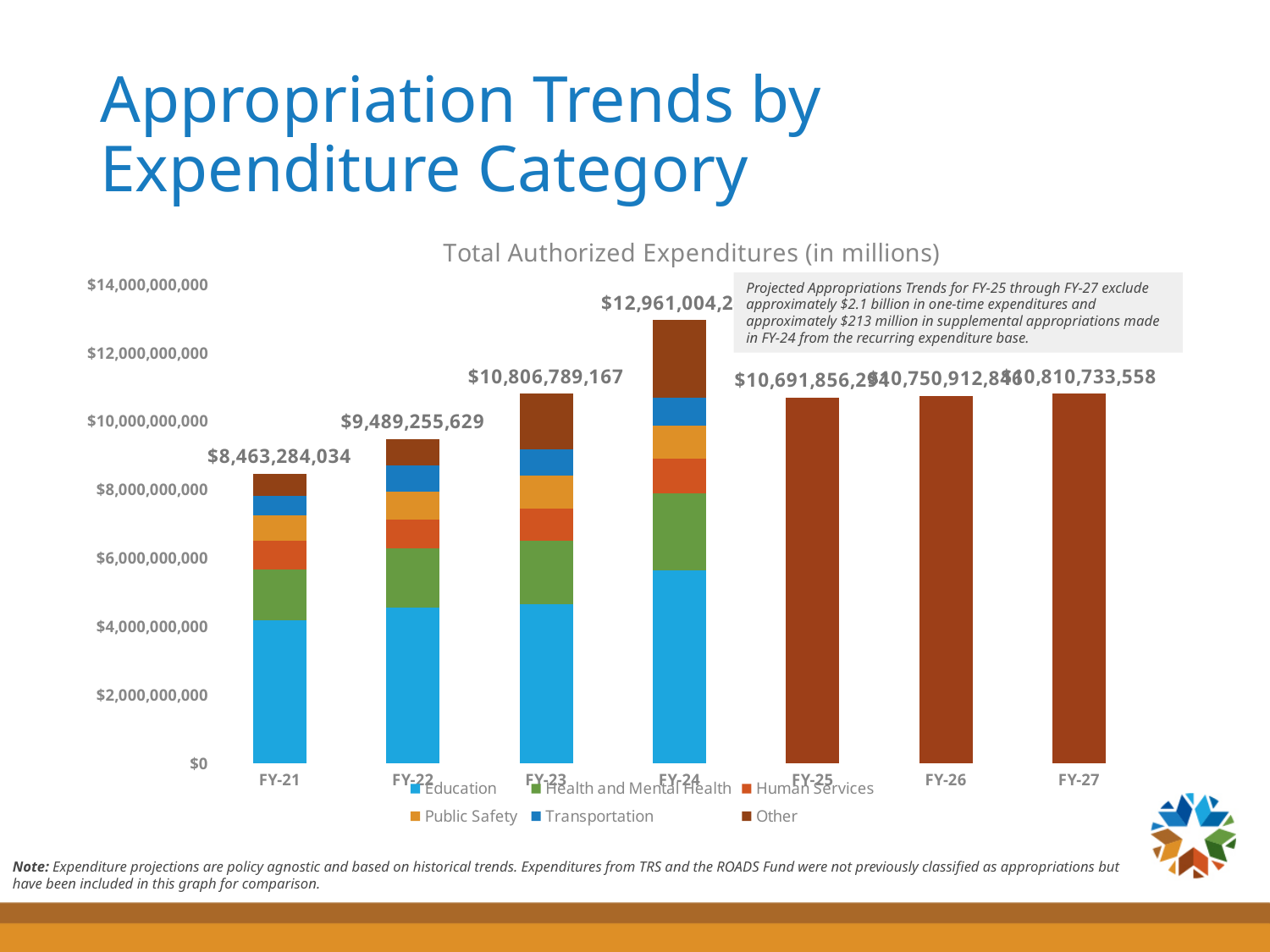
Which fiscal year has the highest total authorized expenditure? FY-24 What is the total authorized expenditure shown for FY-23? $10,806,789,167 What is the total authorized expenditure shown for FY-21? $8,463,284,034 Which is larger, the total for FY-22 or the total for FY-23? FY-23 What kind of chart is shown on the slide? Stacked bar chart What is the difference between the FY-22 total ($9,489,255,629) and the FY-21 total ($8,463,284,034)? $1,025,971,595 How many fiscal years are shown on the x axis? 7 What is the total authorized expenditure shown for FY-27? $10,810,733,558 Is the total for FY-25 greater or less than $12,000,000,000? less How many series does the legend list? 6 Which fiscal year has the lowest total authorized expenditure? FY-21 Is the total for FY-24 greater or less than $12,000,000,000? greater